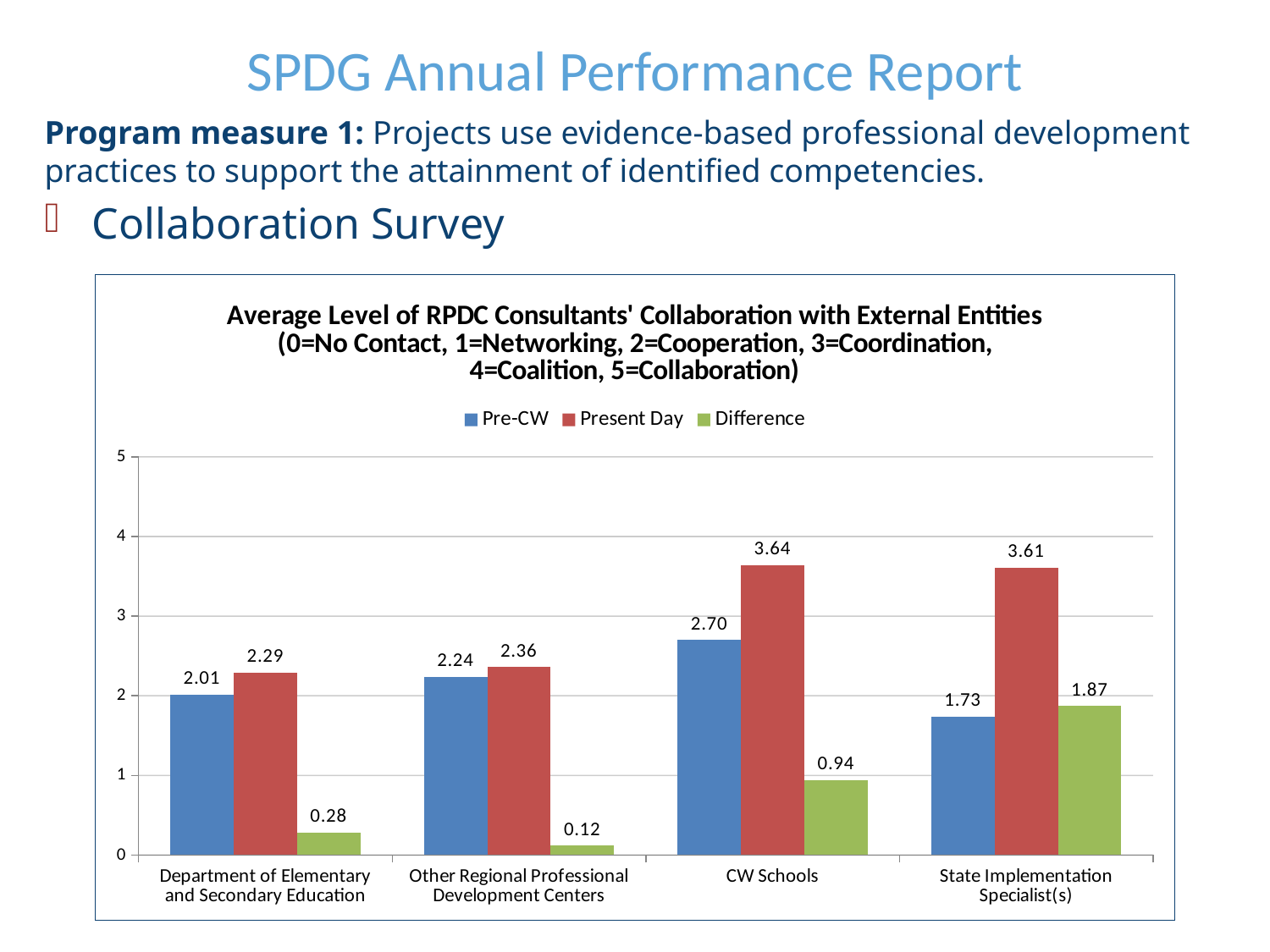
How many categories are shown on the x axis? 4 What is the Pre-CW value for State Implementation Specialist(s)? 1.73 How many series does the legend list? 3 Which category has the highest Present Day value? CW Schools What is the Present Day value for CW Schools? 3.64 What is the difference between the Present Day and Pre-CW values for Department of Elementary and Secondary Education? 0.28 Which is larger, the Difference value for CW Schools or for State Implementation Specialist(s)? State Implementation Specialist(s) Which category has the lowest Pre-CW value? State Implementation Specialist(s) What kind of chart is shown on the slide? bar chart Which series is shown in green in the legend? Difference Is the Present Day value for State Implementation Specialist(s) greater or less than 3? greater What is the Difference value for Other Regional Professional Development Centers? 0.12